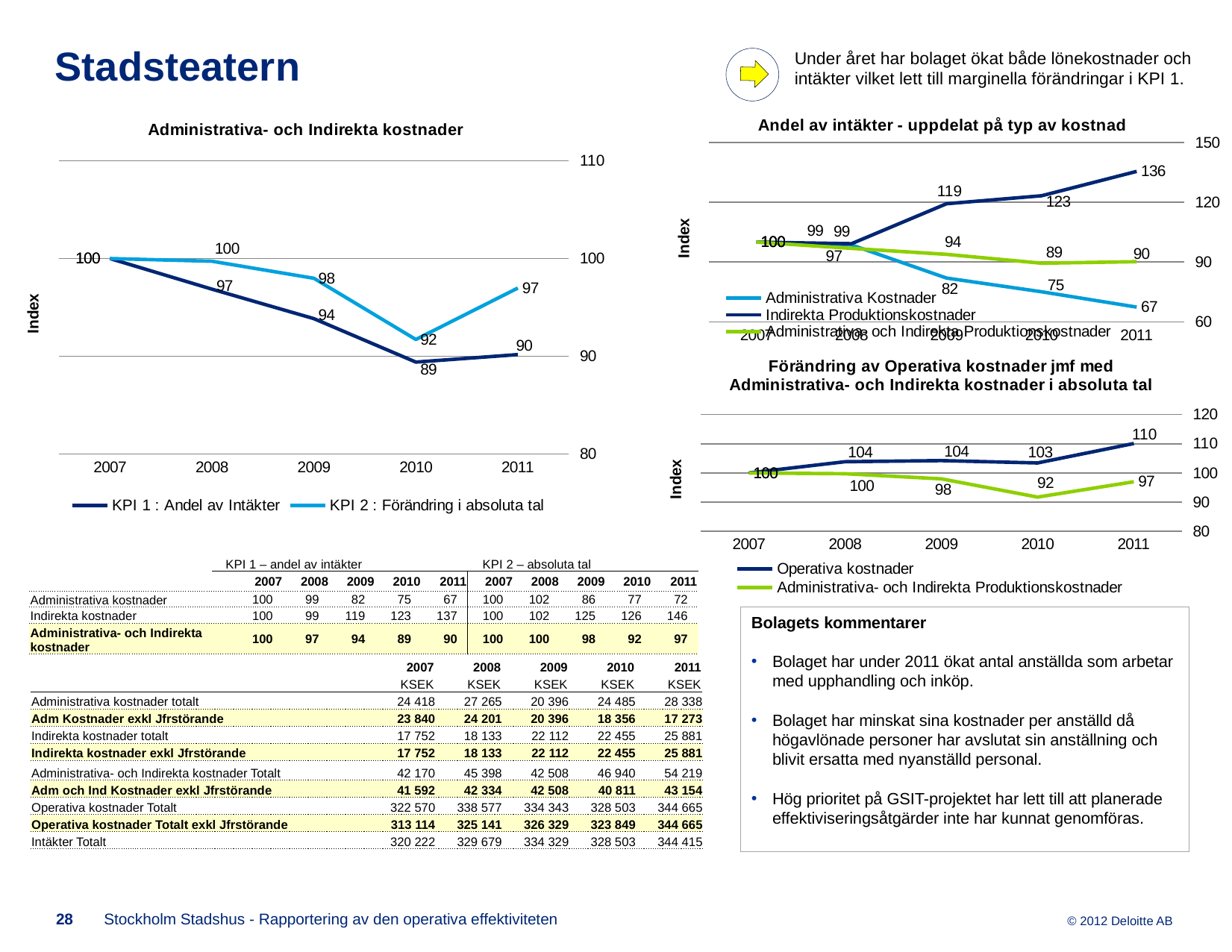
In the chart titled "Förändring av Operativa kostnader jmf med Administrativa- och Indirekta kostnader i absoluta tal", which series has the higher value in 2010, Operativa kostnader or Administrativa- och Indirekta Produktionskostnader? Operativa kostnader In the chart titled "Andel av intäkter - uppdelat på typ av kostnad", what is the value of Indirekta Produktionskostnader in 2011? 136 In the chart titled "Andel av intäkter - uppdelat på typ av kostnad", how many series does the legend list? 3 In the chart titled "Andel av intäkter - uppdelat på typ av kostnad", what is the value of Administrativa Kostnader in 2009? 82 In the chart titled "Andel av intäkter - uppdelat på typ av kostnad", does Administrativa Kostnader rise or fall from 2007 to 2011? fall In the chart titled "Förändring av Operativa kostnader jmf med Administrativa- och Indirekta kostnader i absoluta tal", what is the value of Operativa kostnader in 2011? 110 What kind of chart is the one titled "Förändring av Operativa kostnader jmf med Administrativa- och Indirekta kostnader i absoluta tal"? line chart In the chart titled "Administrativa- och Indirekta kostnader", how many series does the legend list? 2 In the chart titled "Administrativa- och Indirekta kostnader", in which year is KPI 1 : Andel av Intäkter lowest? 2010 In the chart titled "Administrativa- och Indirekta kostnader", what is the value of KPI 1 : Andel av Intäkter in 2010? 89 In the chart titled "Administrativa- och Indirekta kostnader", what is the value of KPI 2 : Förändring i absoluta tal in 2011? 97 In the chart titled "Administrativa- och Indirekta kostnader", what is the difference between KPI 2 and KPI 1 in 2011? 7